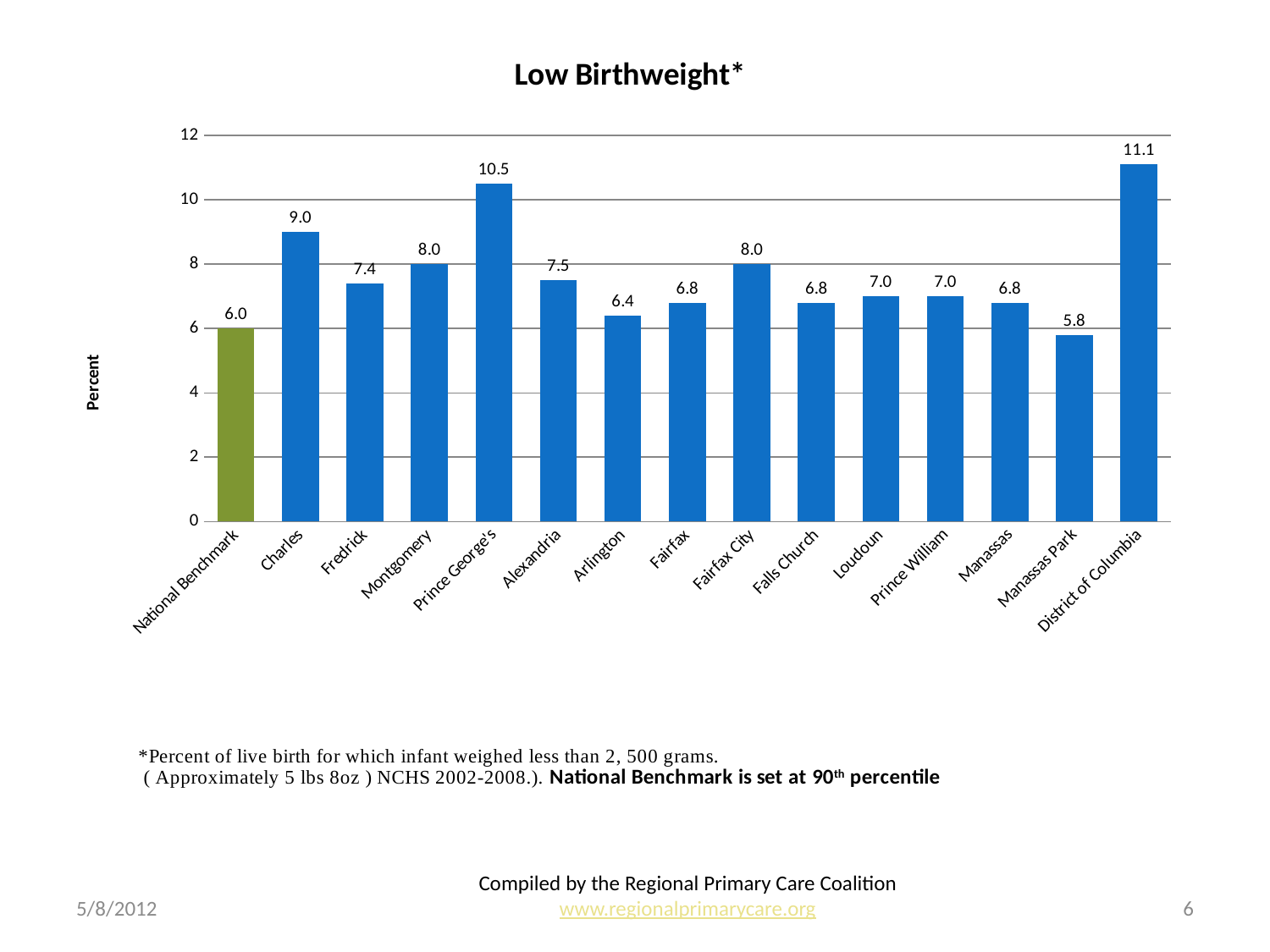
Which is larger, the value for Alexandria or the value for Arlington? Alexandria What is the value for Prince George's? 10.5 What is the value for Manassas Park? 5.8 Which category has the lowest value? Manassas Park What is the label on the vertical axis? Percent How many categories are shown on the x axis? 15 Which category has the highest value? District of Columbia What is the value for the National Benchmark? 6.0 What is the title of the chart? Low Birthweight* Is the value for Charles greater or less than 8? greater What is the difference between the values for District of Columbia and Charles? 2.1 What kind of chart is shown? bar chart